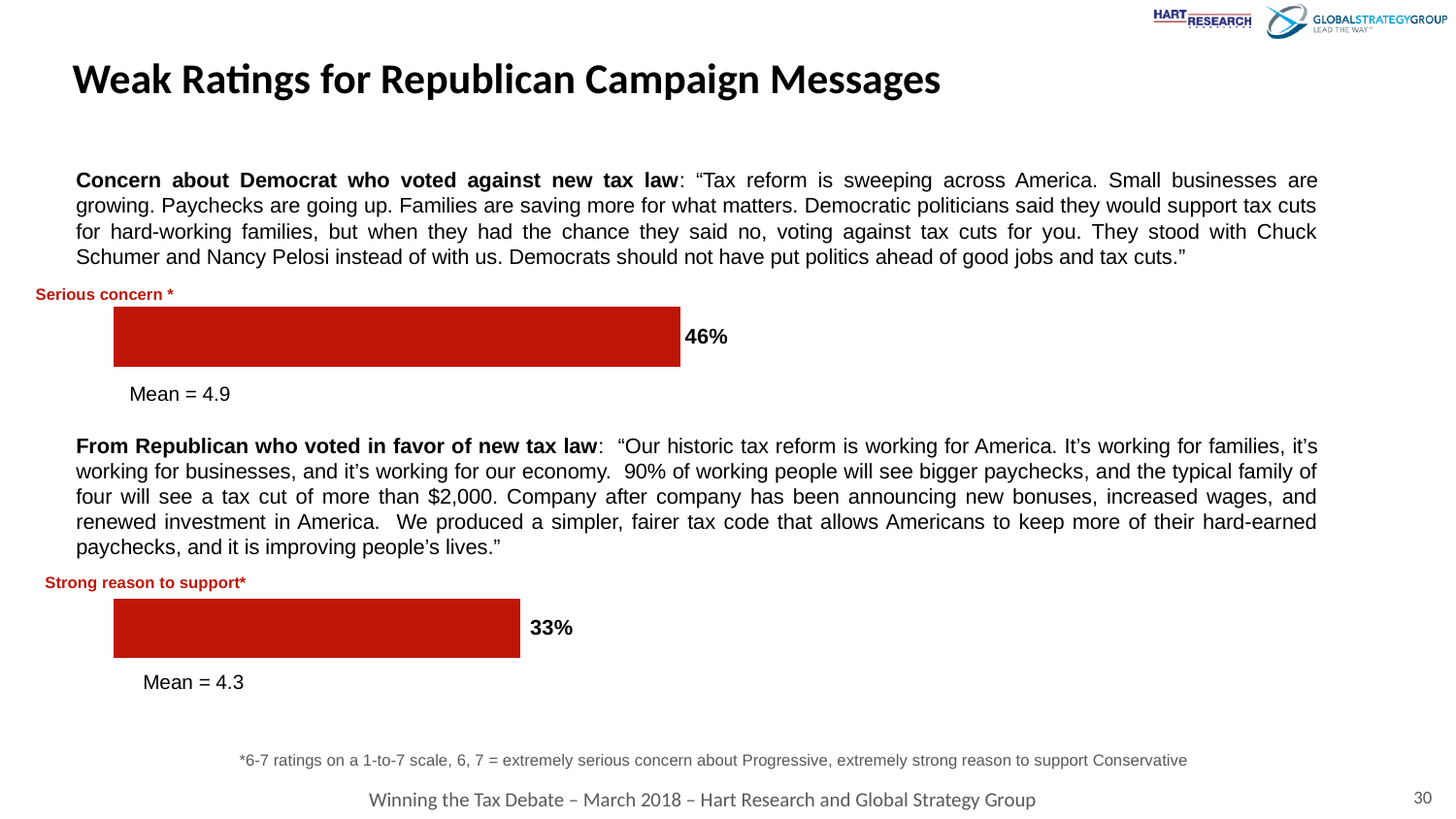
Is the value in the upper "Serious concern *" chart greater or less than 40%? greater What type of chart is used to show the "Serious concern" result in the upper chart? Bar chart What mean value is printed below the bar in the upper "Serious concern *" chart? Mean = 4.9 In the upper chart labeled "Serious concern *", what percentage is shown on the bar? 46% How many bars are plotted in the lower "Strong reason to support*" chart? 1 What is the difference between the "Serious concern" value in the upper chart and the "Strong reason to support" value in the lower chart? 13 percentage points Is the value in the lower "Strong reason to support*" chart greater or less than 40%? less What type of chart is used to show the "Strong reason to support" result in the lower chart? Bar chart How many bars are plotted in the upper "Serious concern *" chart? 1 What mean value is printed below the bar in the lower "Strong reason to support*" chart? Mean = 4.3 Which is larger: the "Serious concern" bar in the upper chart or the "Strong reason to support" bar in the lower chart? Serious concern In the lower chart labeled "Strong reason to support*", what percentage is shown on the bar? 33%